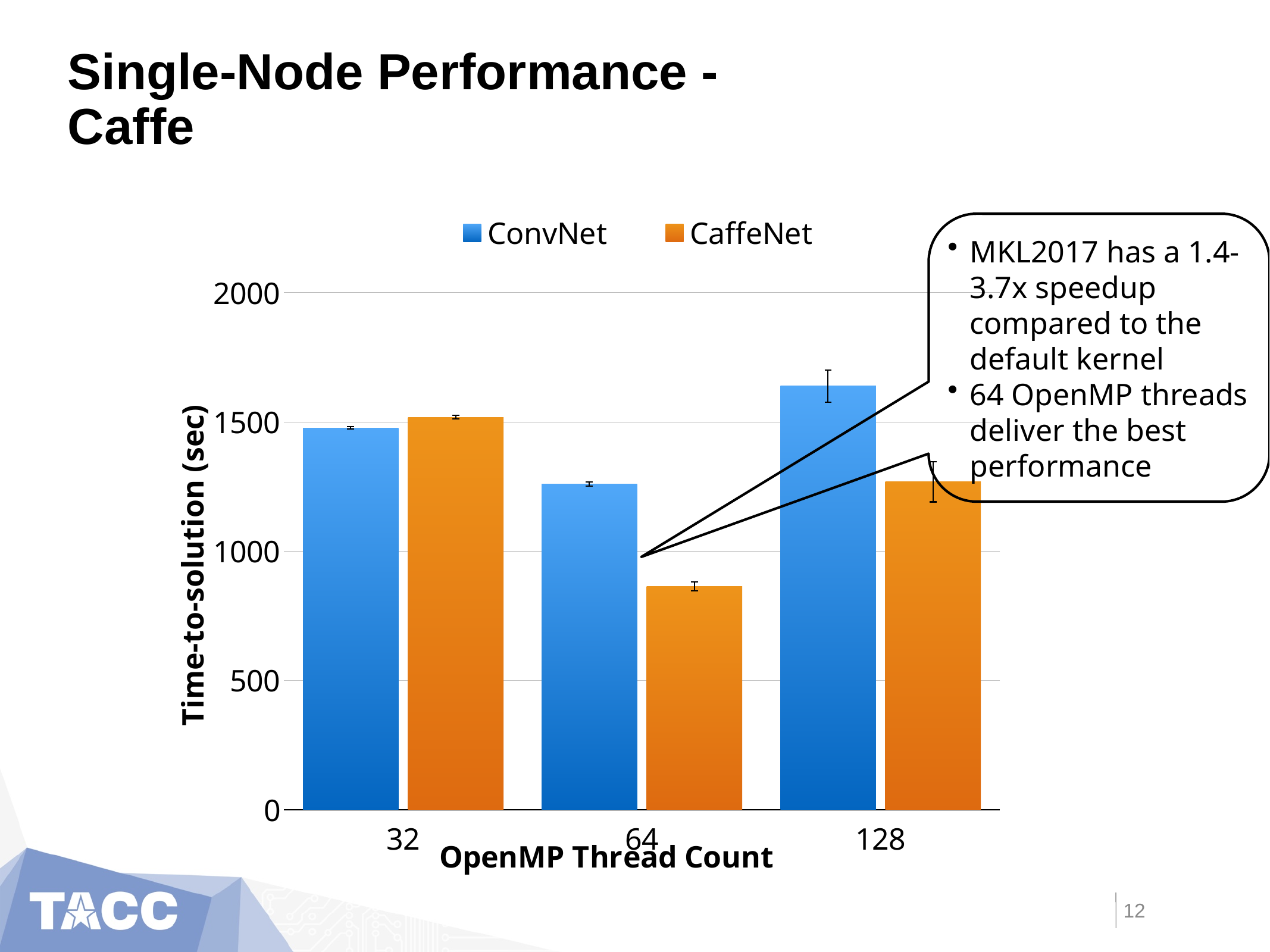
Which series is shown in orange? CaffeNet How many series does the legend list? 2 At which thread count is the ConvNet time-to-solution highest? 128 What kind of chart is shown on the slide? bar chart Is the CaffeNet value at 64 threads greater or less than 1000? less At which thread count is the CaffeNet time-to-solution highest? 32 What is the title of the y axis? Time-to-solution (sec) At 64 threads, which series has the larger time-to-solution, ConvNet or CaffeNet? ConvNet Is the ConvNet value at 64 threads greater or less than 1000? greater How many OpenMP thread count categories are shown on the x axis? 3 At which thread count is the CaffeNet time-to-solution lowest? 64 Is the ConvNet value at 128 threads greater or less than 1500? greater